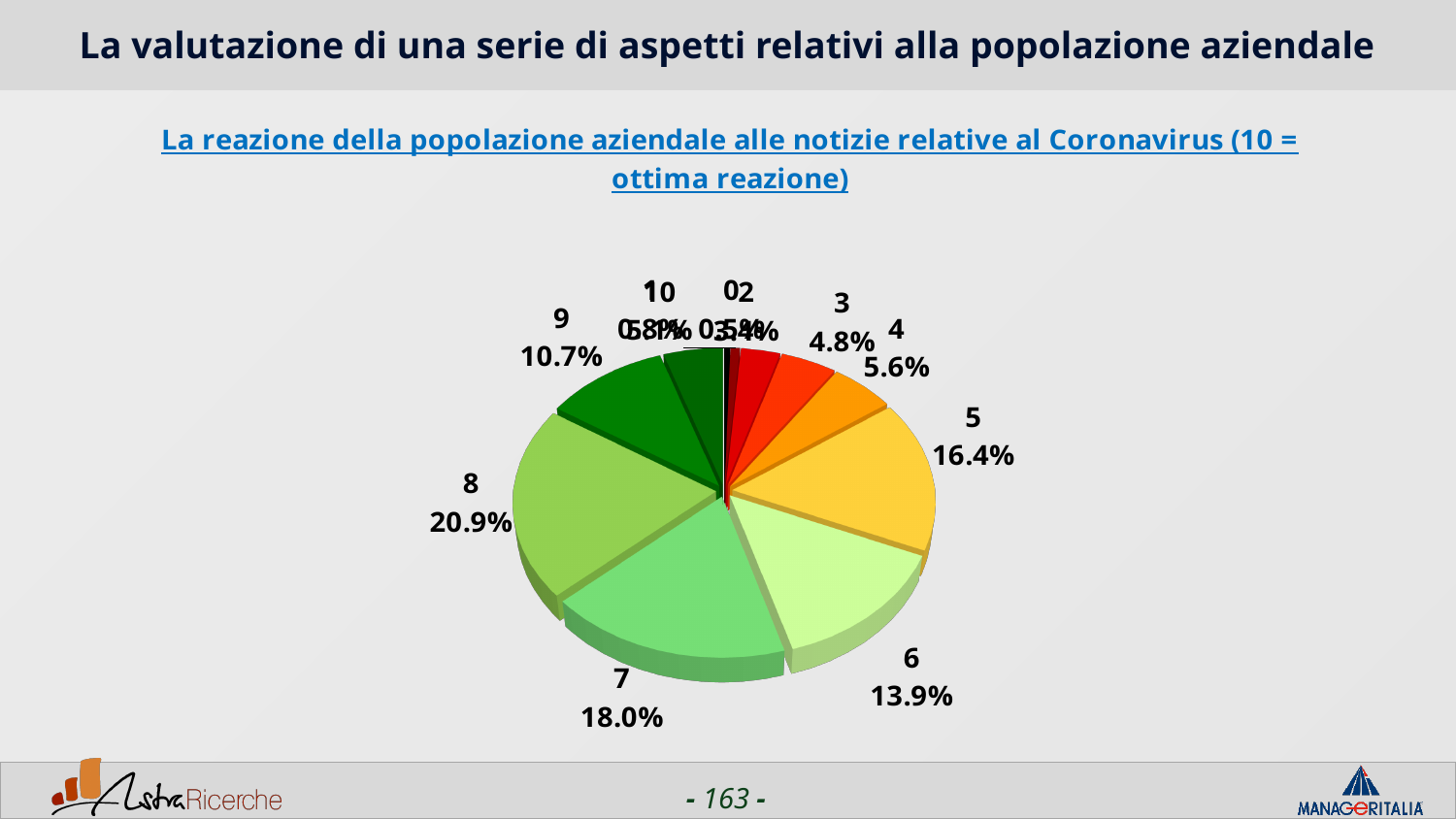
What share of the pie does rating 8 represent? 20.9% Which has a larger share, rating 5 or rating 6? Rating 5 What percentage is shown for rating 5? 16.4% Which rating has the largest slice of the pie? 8 What is the difference in percentage points between rating 8 and rating 7? 2.9 percentage points What is the title of the chart? La reazione della popolazione aziendale alle notizie relative al Coronavirus (10 = ottima reazione) What percentage is shown for rating 7? 18.0% What is the value for rating 4? 5.6% What percentage is shown for rating 9? 10.7% What kind of chart is shown on the slide? Pie chart What is the value for rating 3? 4.8% What is the value for rating 6? 13.9%